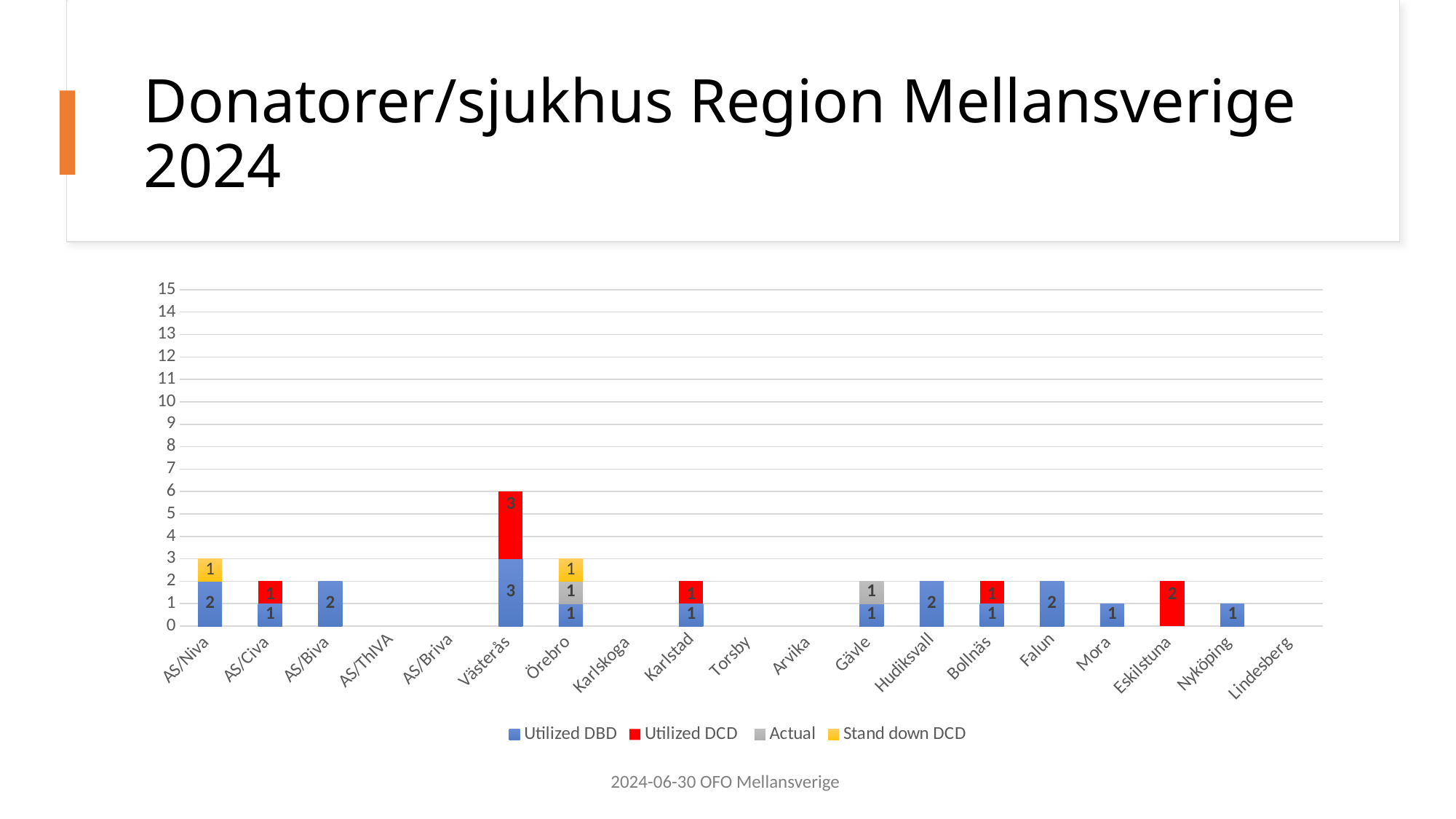
What is the total of the stacked bar for Västerås? 6 How many series does the legend list? 4 What is the total of the stacked bar for Örebro? 3 What is the difference between the Utilized DCD value for Västerås and the Utilized DCD value for Bollnäs? 2 How many hospital categories are shown on the x axis? 19 Which is larger, the Utilized DBD value for Hudiksvall or the Utilized DBD value for Mora? Hudiksvall What is the Stand down DCD value for AS/Niva? 1 What kind of chart is shown on the slide? Stacked bar chart What is the Actual value for Gävle? 1 What is the Utilized DCD value for Eskilstuna? 2 Which hospital has the highest total stacked bar? Västerås What is the Utilized DBD value for Västerås? 3